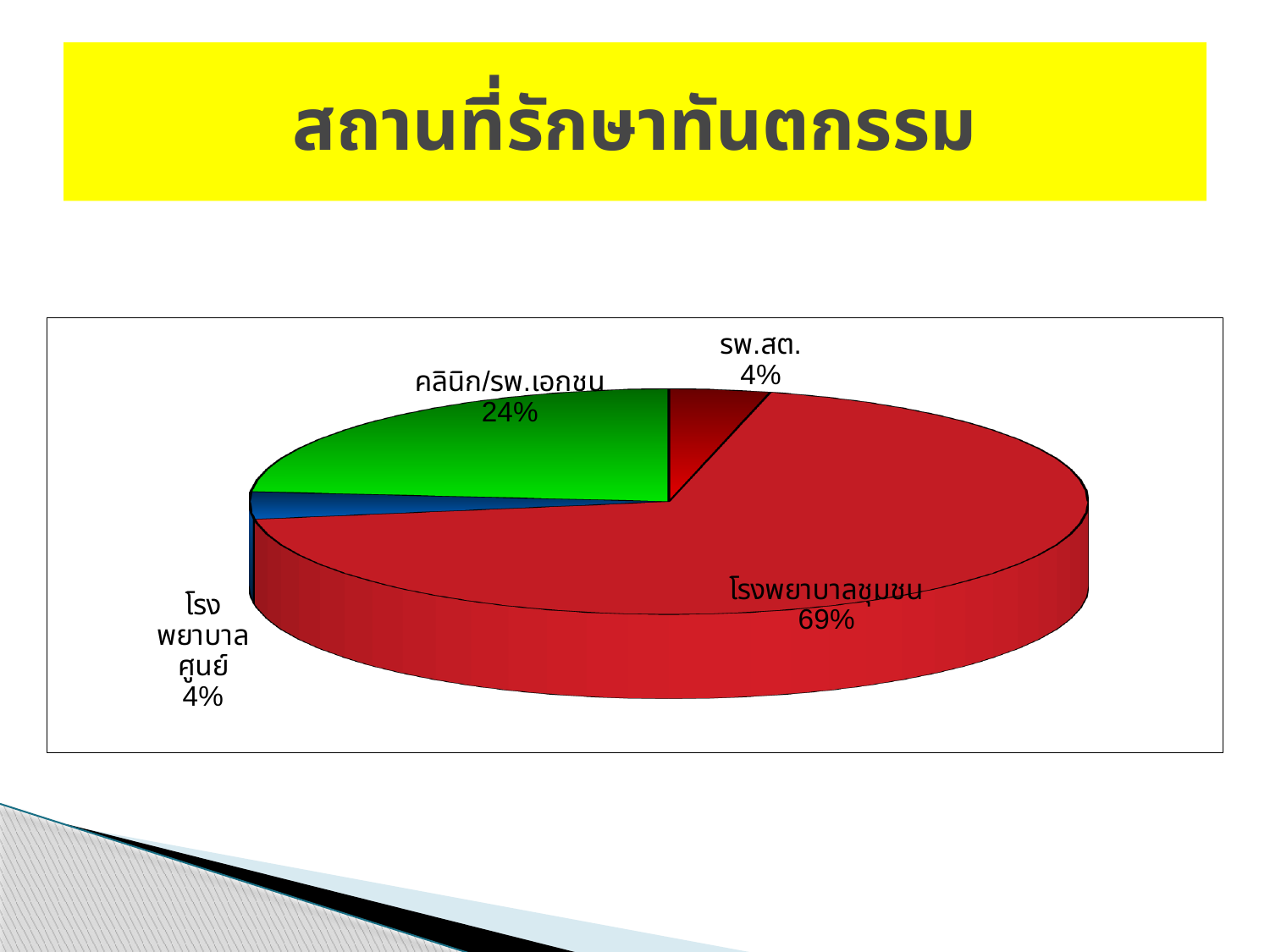
What colour is the slice for คลินิก/รพ.เอกชน? Green What share of the pie does รพ.สต. have? 4% What is the difference in percentage points between คลินิก/รพ.เอกชน and รพ.สต.? 20 Which category has the largest slice of the pie? โรงพยาบาลชุมชน What share of the pie does โรงพยาบาลชุมชน have? 69% What is the difference in percentage points between โรงพยาบาลชุมชน and คลินิก/รพ.เอกชน? 45 Which is larger, the share for คลินิก/รพ.เอกชน or the share for โรงพยาบาลศูนย์? คลินิก/รพ.เอกชน What share of the pie does คลินิก/รพ.เอกชน have? 24% What kind of chart is shown on the slide? Pie chart How many slices does the pie chart have? 4 What is the title of the slide containing the pie chart? สถานที่รักษาทันตกรรม